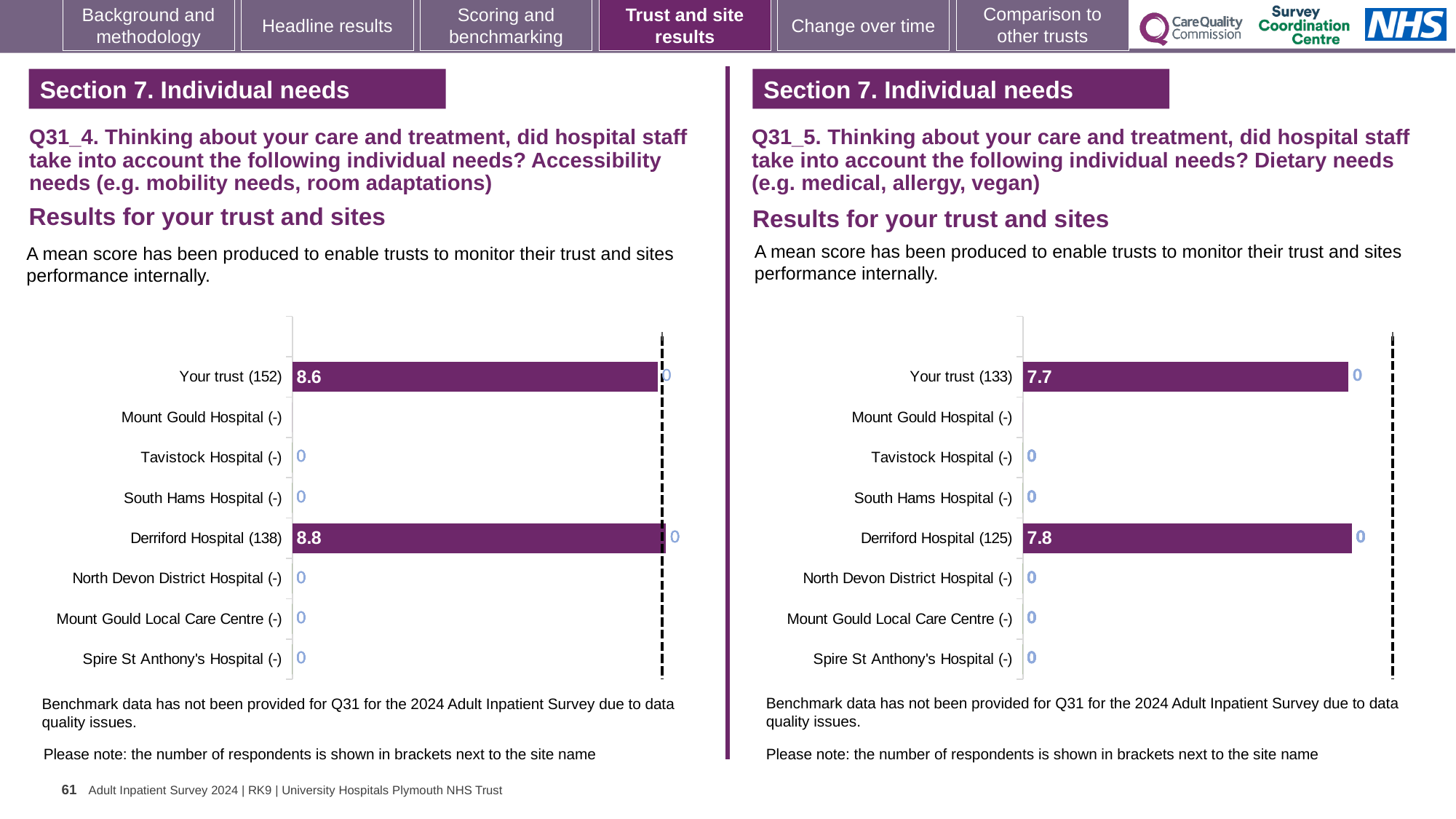
In the left chart (Q31_4, accessibility needs), what is the mean score for Derriford Hospital? 8.8 In the left chart (Q31_4, accessibility needs), which has the higher score: Your trust or Derriford Hospital? Derriford Hospital Is the Your trust score in the left chart (Q31_4) higher or lower than the Your trust score in the right chart (Q31_5)? Higher How many site categories are listed on the y axis of the left chart (Q31_4)? 8 In the right chart (Q31_5, dietary needs), what is the mean score for Derriford Hospital? 7.8 In the left chart (Q31_4), how many respondents are shown in brackets for Derriford Hospital? 138 In the right chart (Q31_5), how many respondents are shown in brackets for Your trust? 133 What type of chart is used on the right side of the slide (Q31_5)? Bar chart In the left chart (Q31_4, accessibility needs), what is the difference between the Derriford Hospital score and the Your trust score? 0.2 In the right chart (Q31_5, dietary needs), what is the difference between the Derriford Hospital score and the Your trust score? 0.1 In the left chart (Q31_4, accessibility needs), what is the mean score for Your trust? 8.6 In the right chart (Q31_5, dietary needs), what is the mean score for Your trust? 7.7